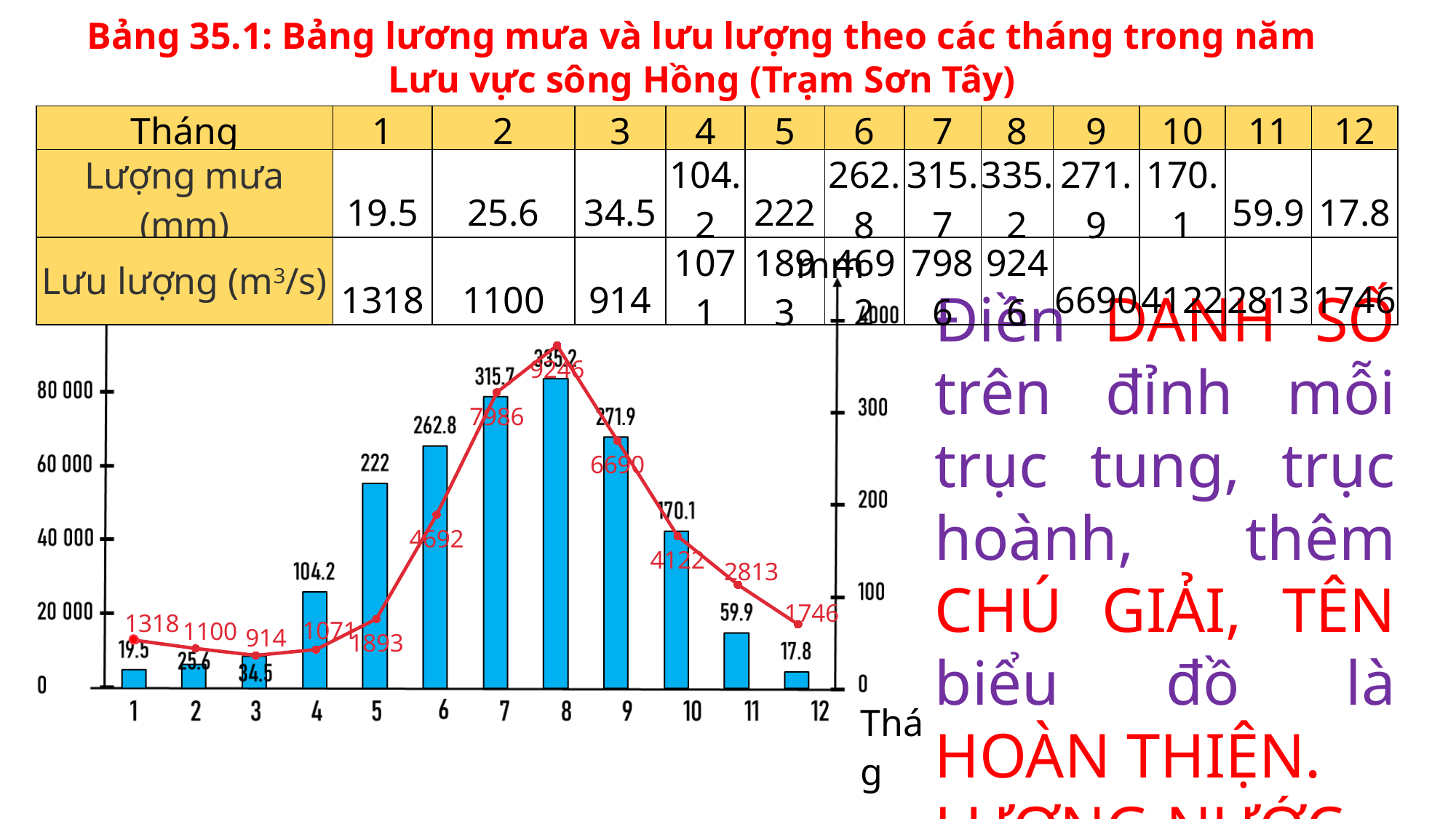
How many months are plotted along the x axis of the chart? 12 Which month has the lowest bar (rainfall)? 12 Which month has the lowest point on the discharge line? 3 What is the discharge value shown on the line for month 7? 7986 What is the rainfall value shown on the bar for month 8? 335.2 Which is larger, the rainfall bar for month 6 or for month 9? month 9 What is the rainfall value shown on the bar for month 5? 222 Which month has the highest bar (rainfall)? 8 What is the difference between the rainfall values for month 8 and month 7? 19.5 What is the difference between the discharge values for month 8 and month 9? 2556 Do the rainfall bars rise or fall from month 8 to month 12? fall What kind of chart is shown on the slide? combined bar and line chart